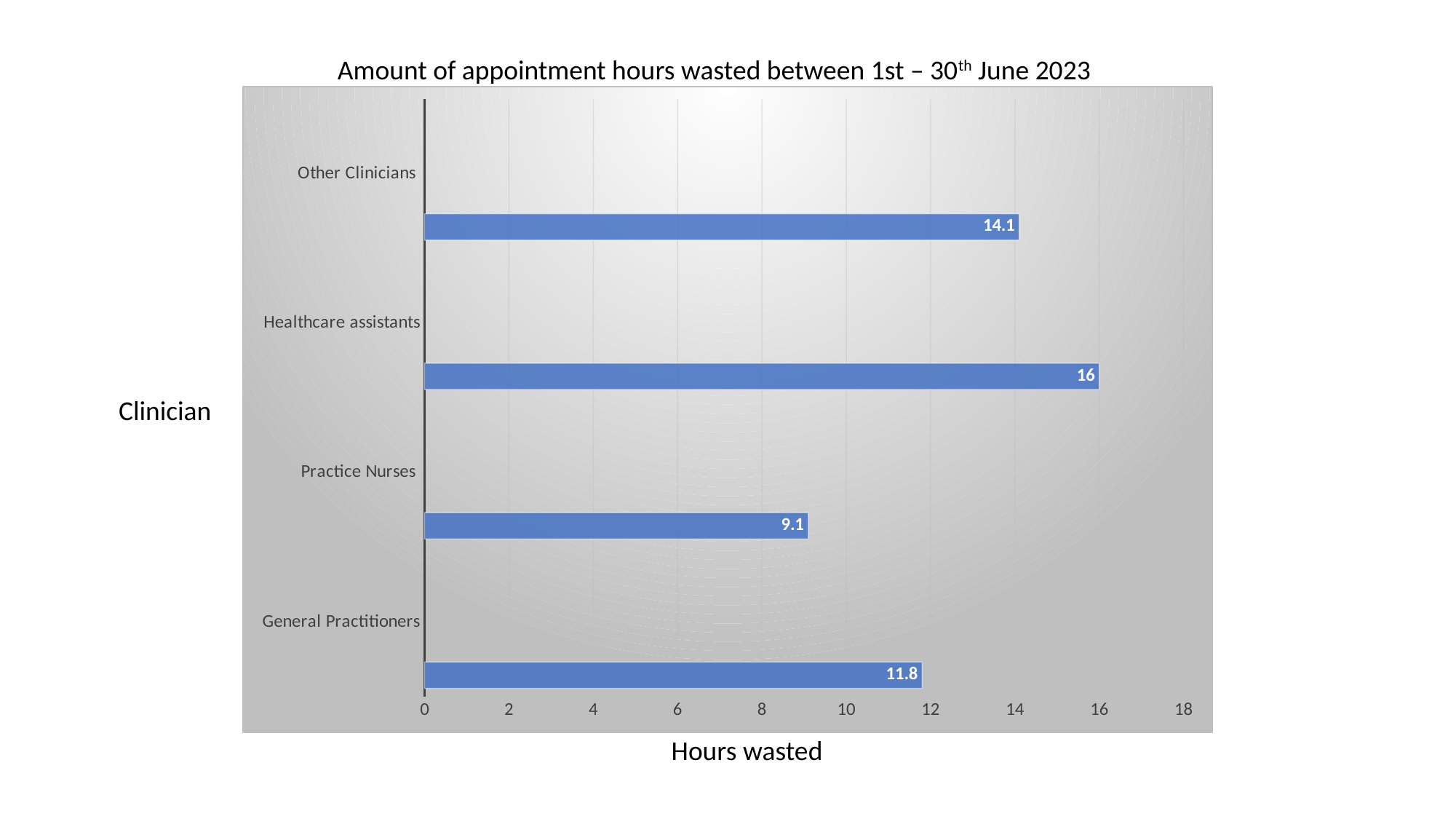
How many hours were wasted for General Practitioners? 11.8 What is the difference in hours wasted between Healthcare assistants and Practice Nurses? 6.9 How many hours were wasted for Other Clinicians? 14.1 How many hours were wasted for Healthcare assistants? 16 What type of chart is shown on the slide? bar chart Which clinician category has the lowest number of hours wasted? Practice Nurses How many hours were wasted for Practice Nurses? 9.1 How many clinician categories are plotted in the chart? 4 What is the label of the horizontal axis? Hours wasted Which clinician category has the highest number of hours wasted? Healthcare assistants Which has more hours wasted, Other Clinicians or General Practitioners? Other Clinicians What is the title of the chart? Amount of appointment hours wasted between 1st – 30th June 2023